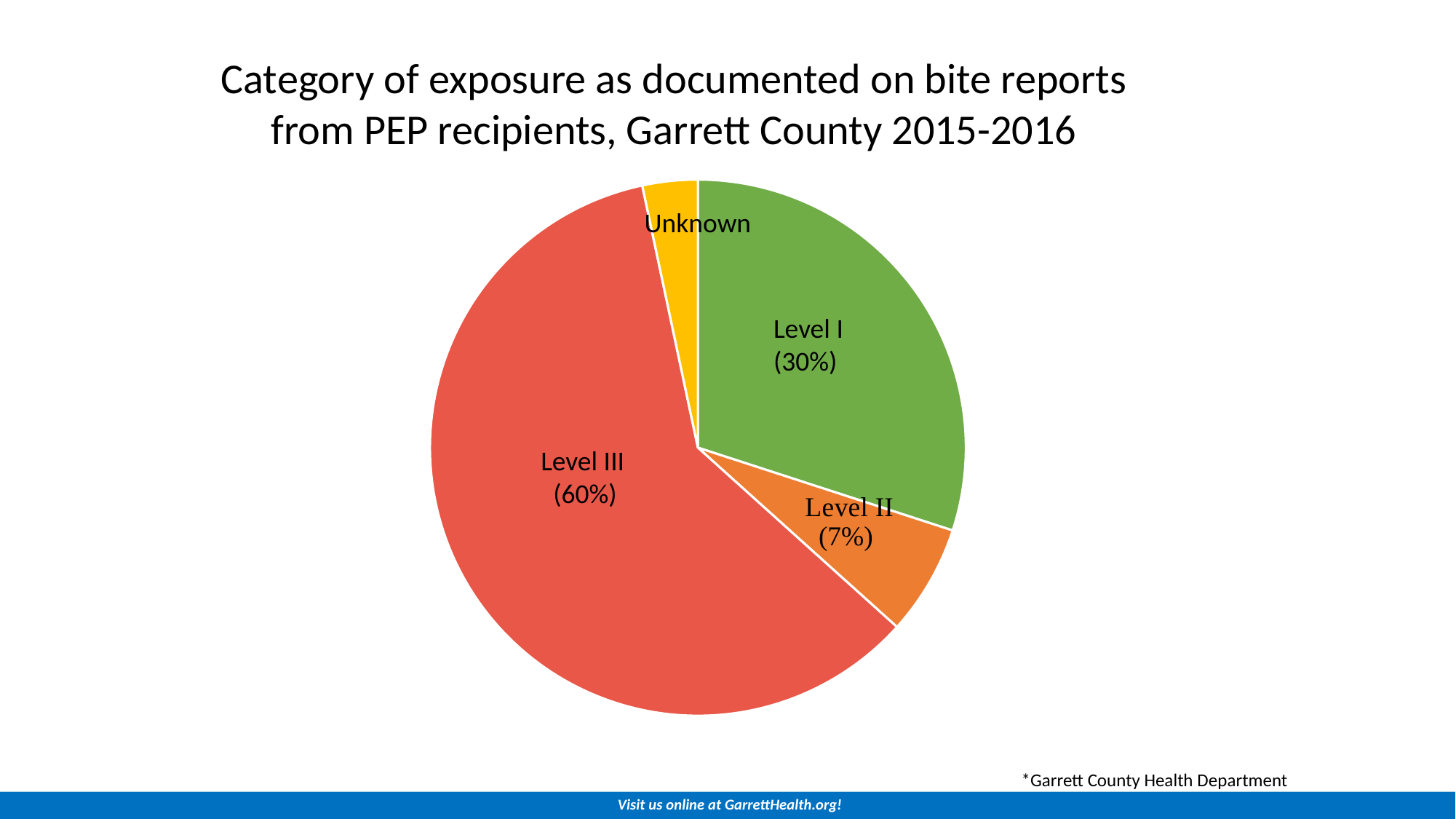
Which is larger, the Level I slice or the Level II slice? Level I Which is larger, the Level II slice or the Unknown slice? Level II Which category has the largest slice of the pie? Level III What is the title of the chart? Category of exposure as documented on bite reports from PEP recipients, Garrett County 2015-2016 Which category has the smallest slice of the pie? Unknown What share of the pie does Level II represent? 7% What is the difference in percentage points between Level III and Level I? 30 What is the difference in percentage points between Level I and Level II? 23 What kind of chart is shown on the slide? pie chart What share of the pie does Level III represent? 60% What share of the pie does Level I represent? 30% How many slices does the pie chart have? 4